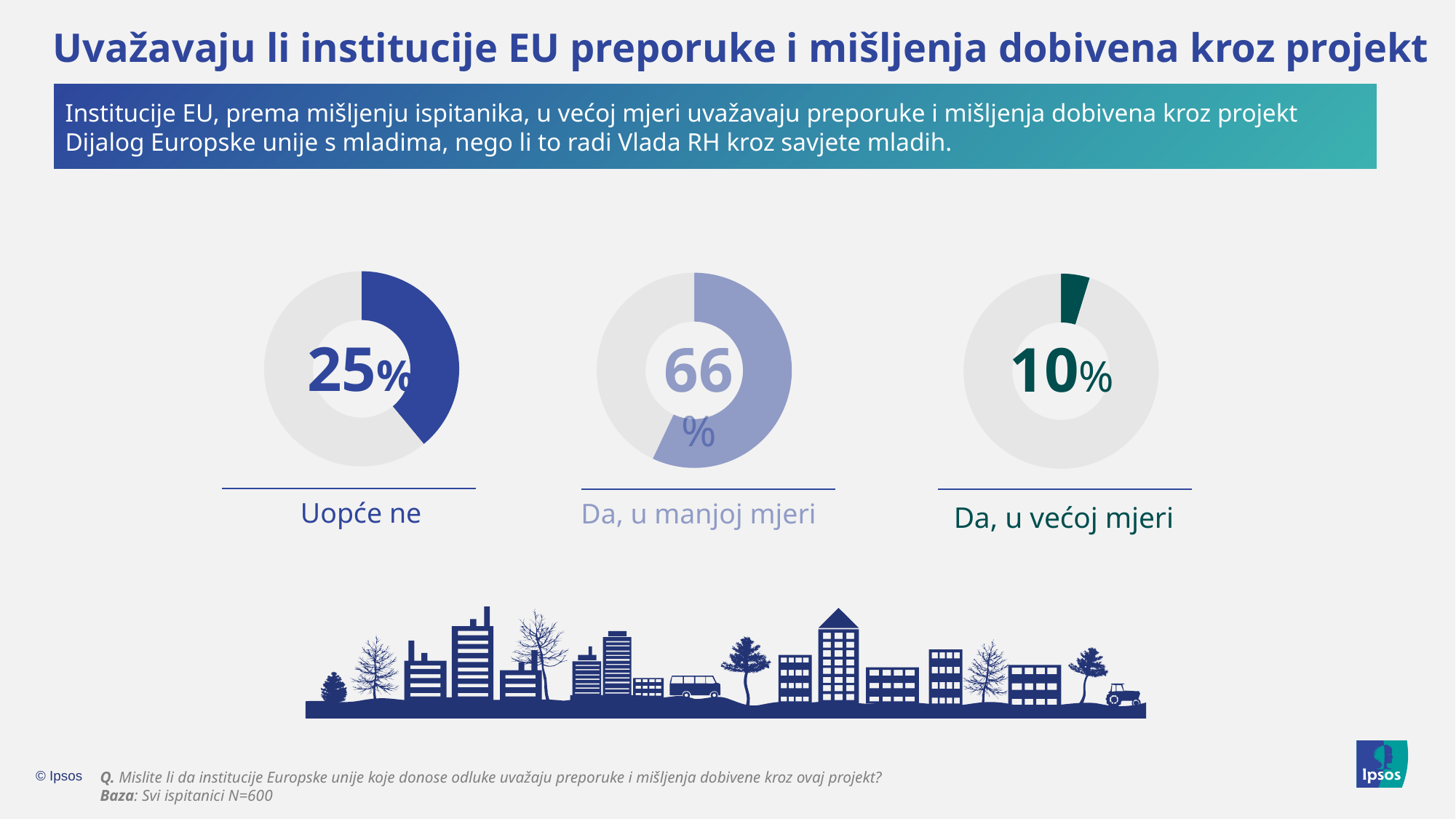
What percentage is shown in the donut chart labelled "Da, u manjoj mjeri"? 66% What is the difference in percentage points between "Da, u manjoj mjeri" and "Uopće ne"? 41 What is the difference in percentage points between "Uopće ne" and "Da, u većoj mjeri"? 15 What kind of chart is used to display the three percentages? Donut chart What percentage is shown in the donut chart labelled "Da, u većoj mjeri"? 10% Which is larger, the value for "Uopće ne" or the value for "Da, u većoj mjeri"? Uopće ne What is the sample size (Baza) stated at the bottom of the slide? N=600 Which of the three response categories has the highest percentage? Da, u manjoj mjeri What is the combined percentage of the two "Da" responses ("Da, u manjoj mjeri" and "Da, u većoj mjeri")? 76% How many donut charts are shown on the slide? 3 Which of the three response categories has the lowest percentage? Da, u većoj mjeri What percentage is shown in the donut chart labelled "Uopće ne"? 25%